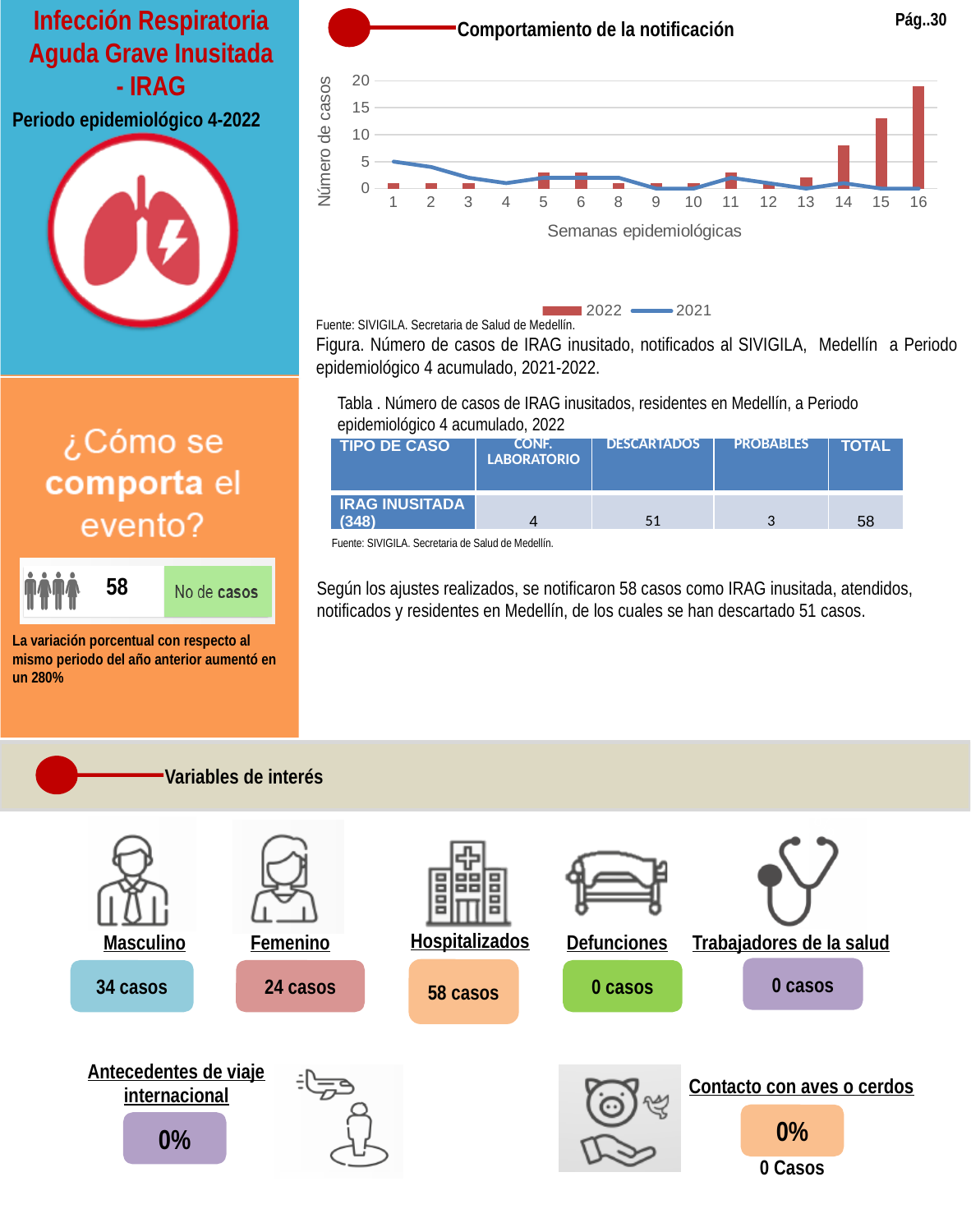
How many epidemiological weeks are labelled on the x axis of the chart? 15 Which series in the chart is drawn as bars? 2022 How many series does the legend of the chart list? 2 In which epidemiological week is the 2022 value highest? 16 Do the 2022 bars rise or fall over the last three weeks shown (14 to 16)? rise Is the 2022 value for week 15 greater or less than 10? greater In week 16, which series has the larger value, 2022 or 2021? 2022 Is the 2022 value for week 1 greater or less than 5? less Is the 2022 value for week 16 greater or less than 15? greater What is the title of the x axis of the chart? Semanas epidemiológicas What kind of chart is shown under 'Comportamiento de la notificación'? A combined bar and line chart